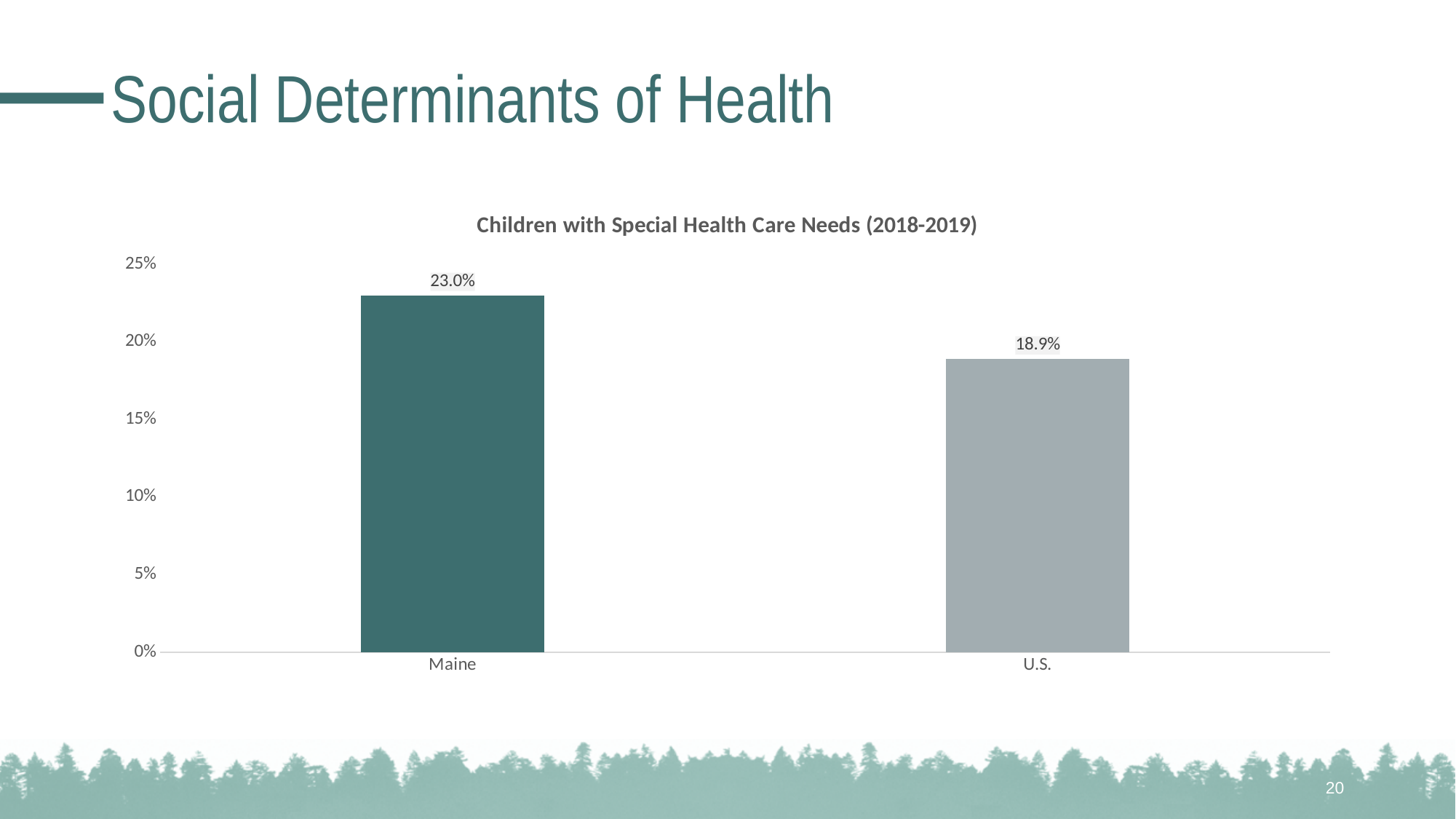
What is the highest value shown on the vertical axis of the chart? 25% What is the title of the chart? Children with Special Health Care Needs (2018-2019) What is the difference between the Maine and U.S. values? 4.1% Which category has the highest value in the chart? Maine Is the value for U.S. greater or less than 20%? less Is the value for Maine greater or less than 20%? greater What is the value for Maine in the Children with Special Health Care Needs chart? 23.0% Which category has the lowest value in the chart? U.S. What is the value for U.S. in the Children with Special Health Care Needs chart? 18.9% Which is larger, the value for Maine or the value for U.S.? Maine How many categories are shown in the chart? 2 What kind of chart is shown on the slide? bar chart